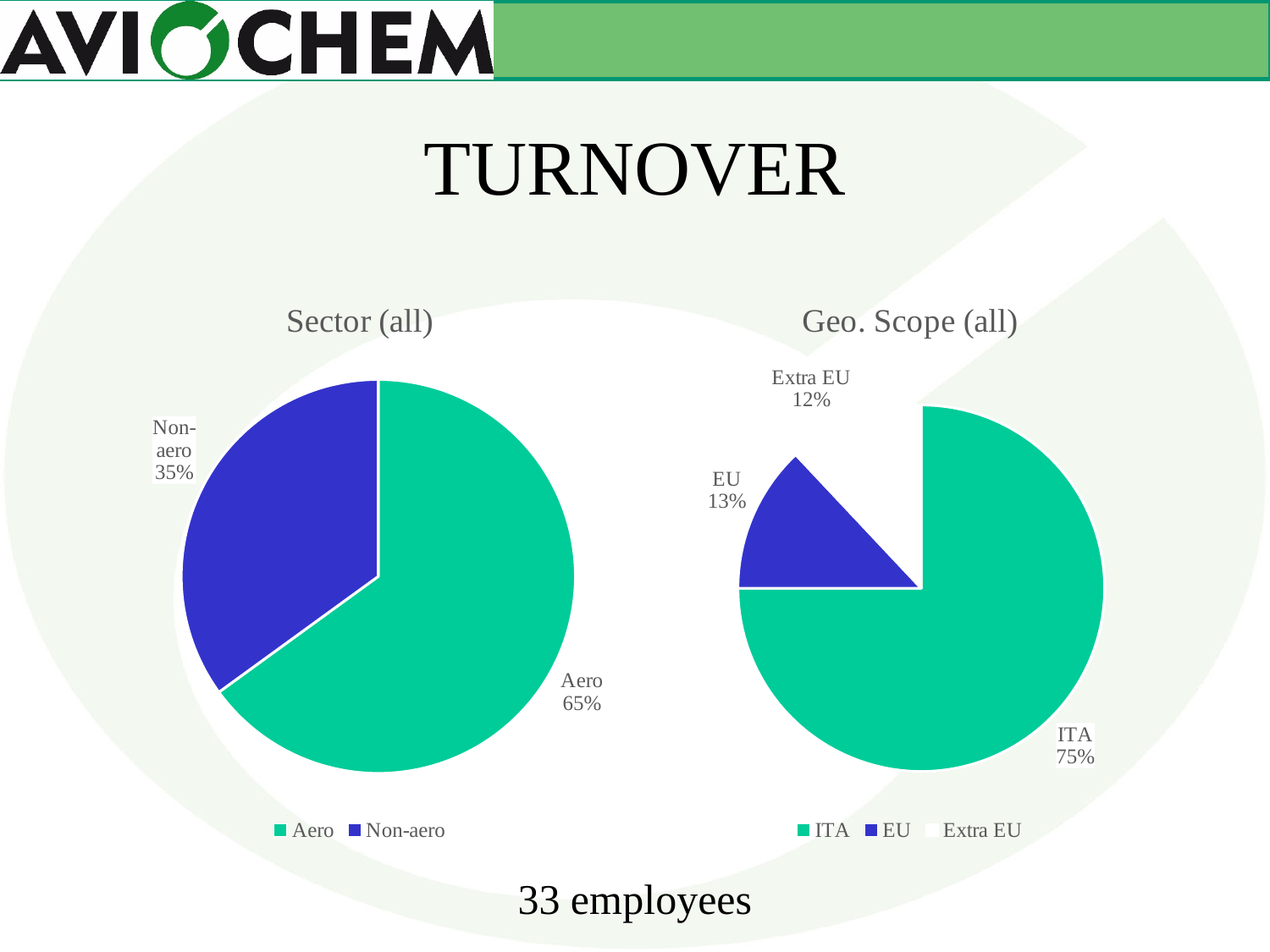
In the 'Sector (all)' chart, what share of turnover is Aero? 65% In the 'Sector (all)' chart, what share of turnover is Non-aero? 35% In the 'Geo. Scope (all)' chart, what share of turnover is Extra EU? 12% In the 'Geo. Scope (all)' chart, which category has the largest share? ITA In the 'Geo. Scope (all)' chart, which is larger, ITA or EU? ITA In the 'Geo. Scope (all)' chart, what share of turnover is ITA? 75% What kind of chart is the 'Sector (all)' chart? Pie chart In the 'Geo. Scope (all)' chart, what share of turnover is EU? 13% How many categories does the 'Geo. Scope (all)' chart show? 3 In the 'Geo. Scope (all)' chart, which category has the smallest share? Extra EU What entries does the legend of the 'Geo. Scope (all)' chart list? ITA, EU, Extra EU In the 'Sector (all)' chart, what is the difference in percentage points between Aero and Non-aero? 30